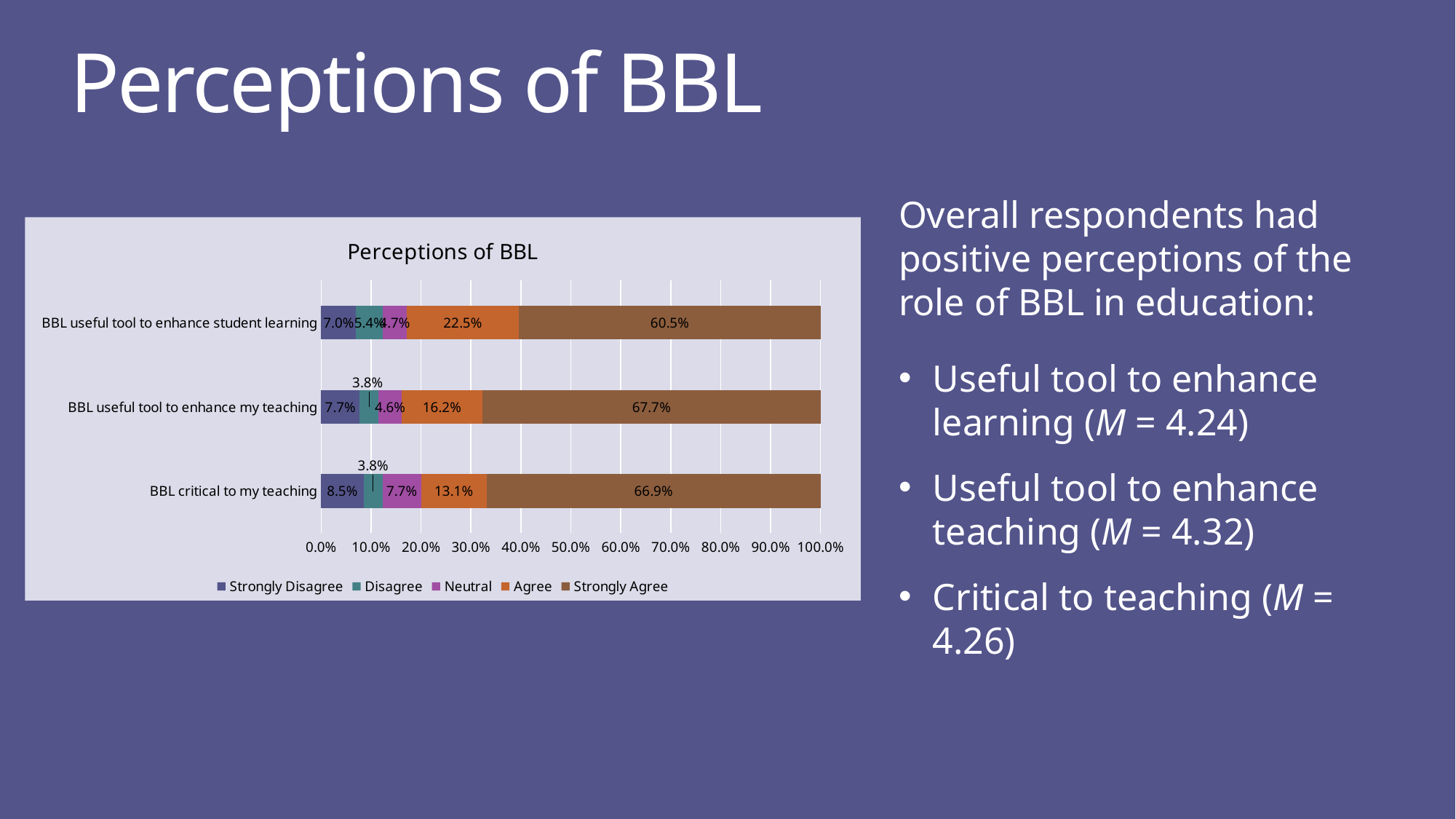
Which statement has the highest Strongly Agree value? BBL useful tool to enhance my teaching Which is larger: the Strongly Disagree value for "BBL critical to my teaching" or for "BBL useful tool to enhance student learning"? BBL critical to my teaching What is the title of the chart? Perceptions of BBL What is the Agree value for "BBL useful tool to enhance student learning"? 22.5% What is the Strongly Agree value for "BBL useful tool to enhance my teaching"? 67.7% What is the difference between the Agree values for "BBL useful tool to enhance student learning" and "BBL critical to my teaching"? 9.4% How many categories (statements) are plotted on the chart? 3 Which statement has the lowest Agree value? BBL critical to my teaching How many series does the legend list? 5 What is the Neutral value for "BBL critical to my teaching"? 7.7% What kind of chart is shown on the slide? Stacked bar chart What is the Strongly Disagree value for "BBL critical to my teaching"? 8.5%